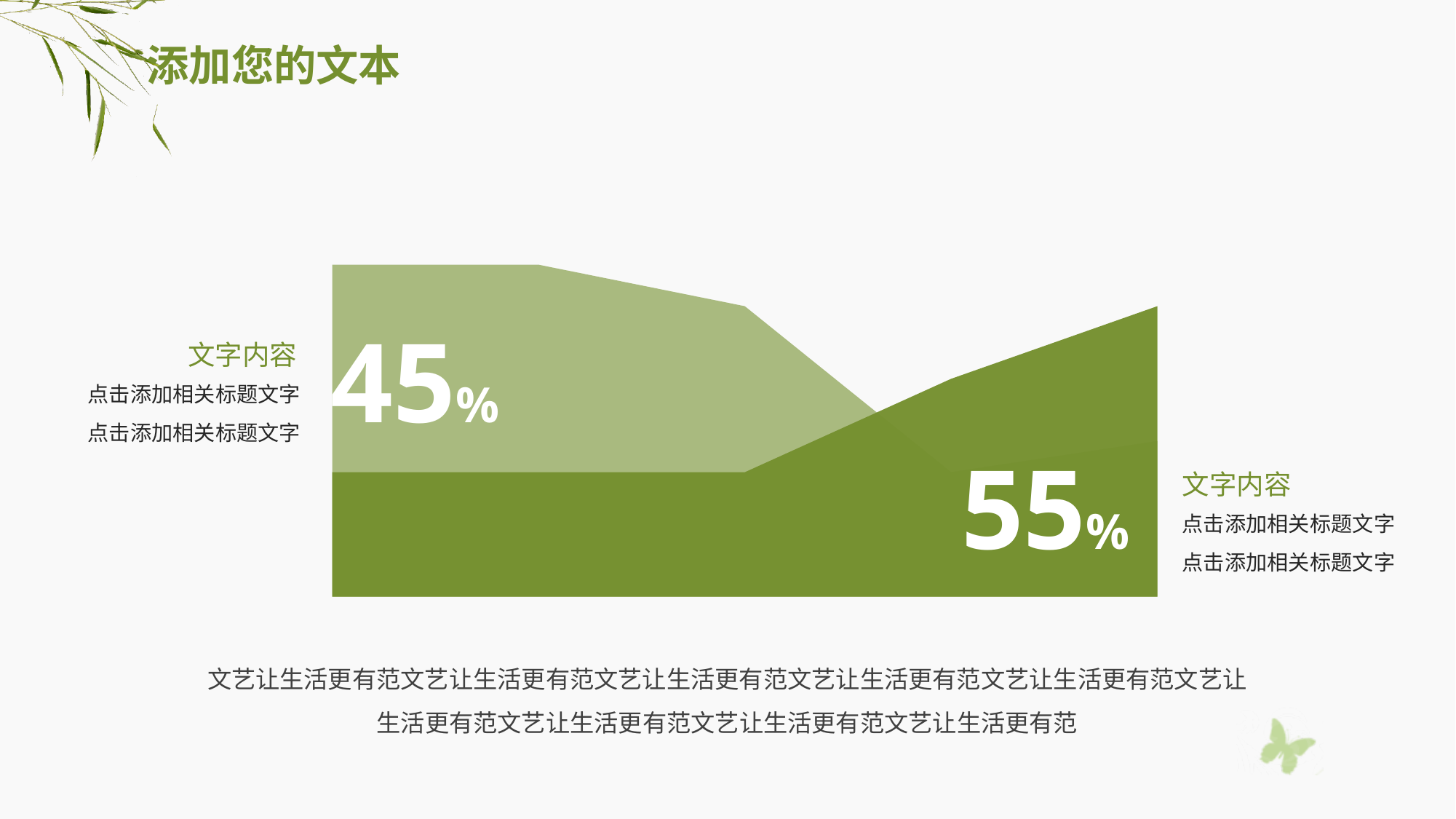
Which of the two percentages shown on the chart is the smallest? 45% Which of the two percentages shown on the chart is the largest? 55% What percentage is printed on the light green area on the left of the chart? 45% What is the title at the top of the slide? 添加您的文本 What kind of chart is shown on the slide? area chart What is the difference between the two percentages shown on the chart? 10% Which area shows the larger percentage, the light green one or the dark green one? the dark green one (55%) What do the two percentages shown on the chart add up to? 100% What percentage is printed on the dark green area on the right of the chart? 55% Does the dark green area rise or fall from left to right? rise How many percentage values are printed on the chart? 2 Does the light green area rise or fall from left to right? fall